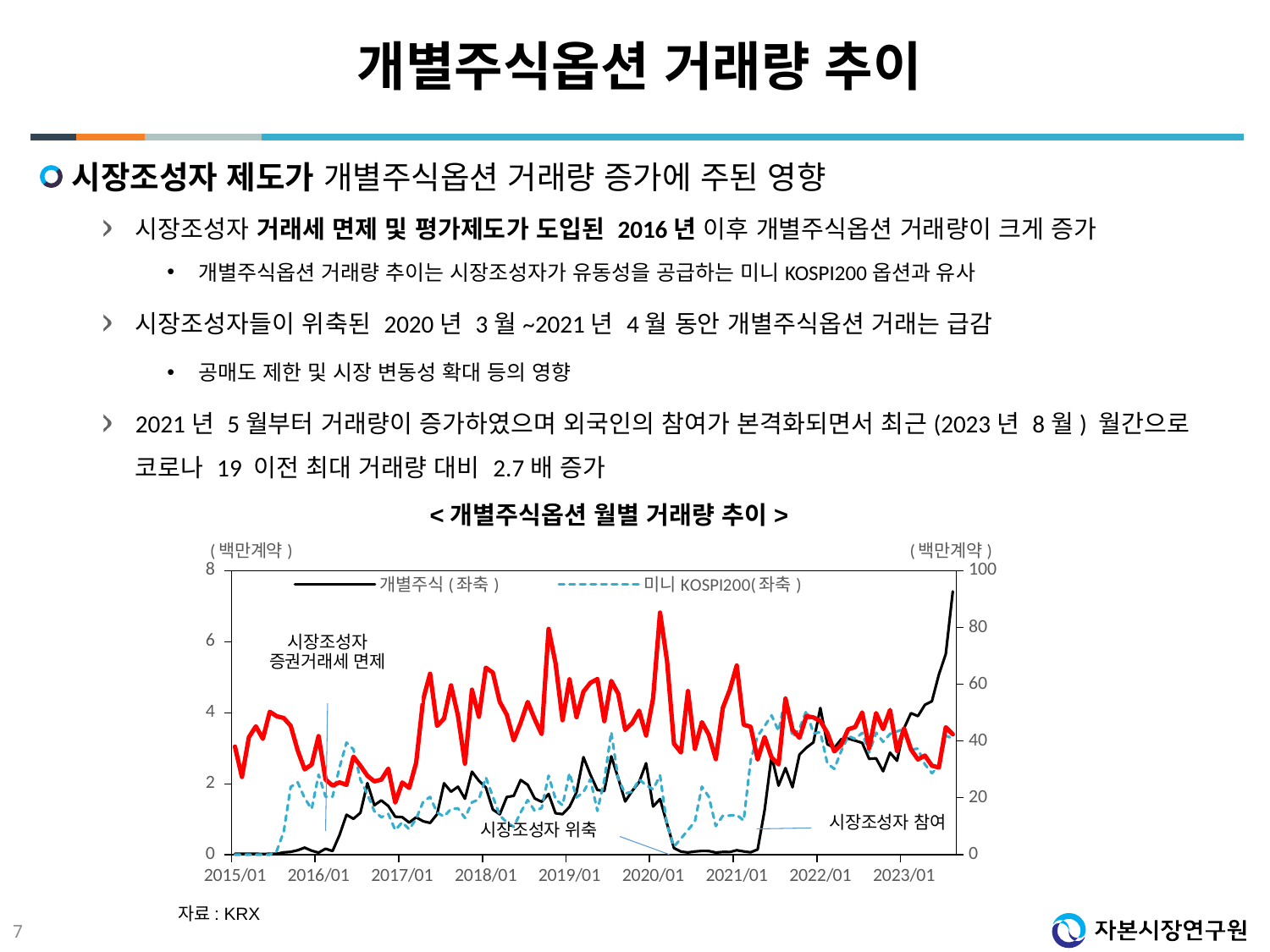
Does the 개별주식 (좌축) series rise or fall from 2021/01 to the end of the chart? rise Is the value of the 개별주식 (좌축) series around 2020/07 greater or less than 2? less How many year labels are shown along the x axis of the chart? 9 What kind of chart is shown on the slide? line chart What is the maximum value shown on the right axis of the chart? 100 Is the value of the 개별주식 (좌축) series at its peak in 2023 greater or less than 6? greater What is the data source cited below the chart? KRX What unit is shown for the chart's axes? 백만계약 What is the title of the chart on the slide? < 개별주식옵션 월별 거래량 추이 > Is the value of the 미니 KOSPI200(좌축) series at 2015/01 greater or less than 2? less What is the maximum value shown on the left axis of the chart? 8 How many series does the chart's legend list? 2